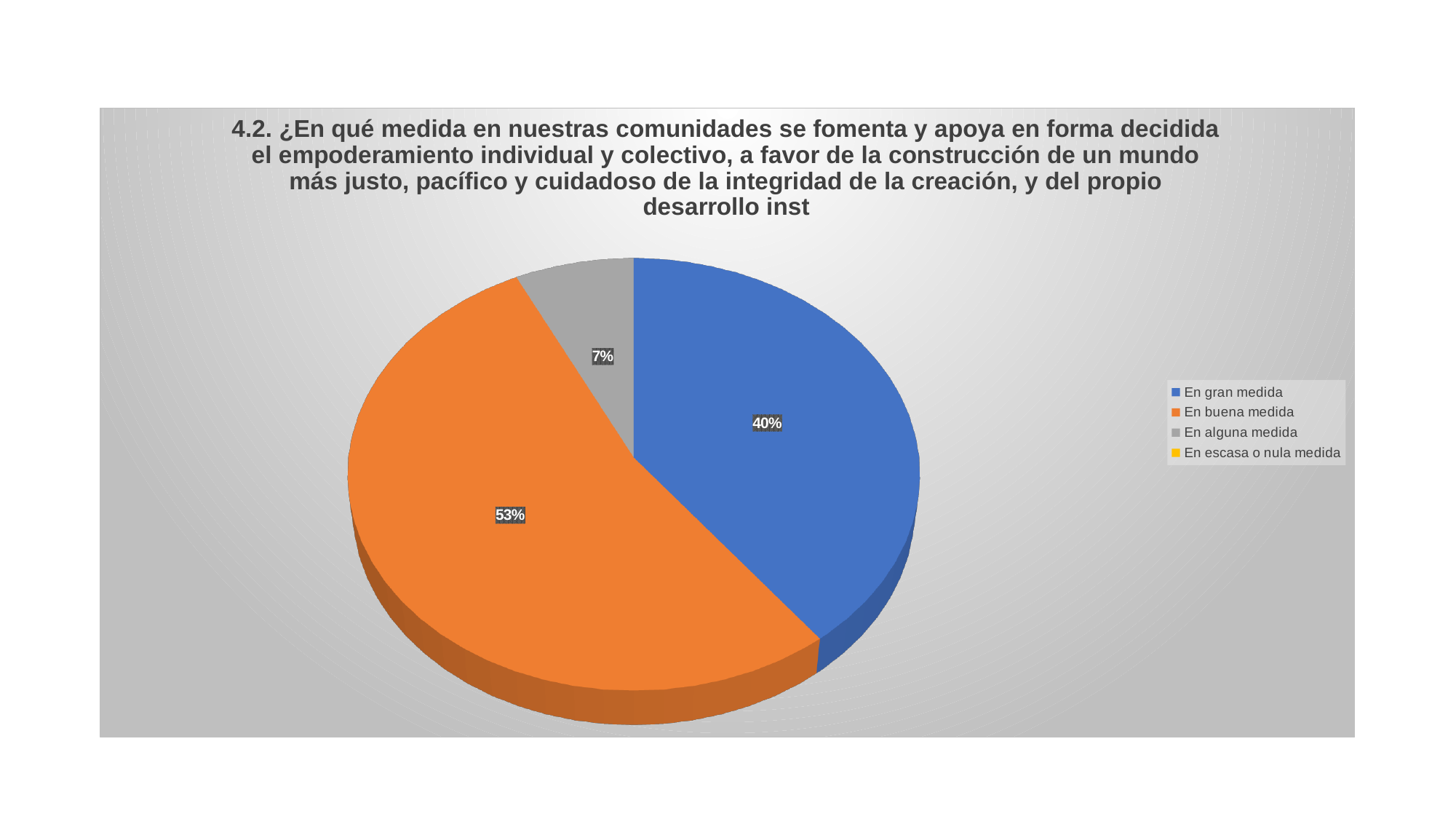
Which legend entry is shown in yellow? En escasa o nula medida What is the difference in percentage points between "En buena medida" and "En gran medida"? 13 What share of the pie does "En alguna medida" represent? 7% What colour is the slice for "En buena medida"? orange What is the difference in percentage points between "En gran medida" and "En alguna medida"? 33 Which category has the largest share of the pie? En buena medida What share of the pie does "En gran medida" represent? 40% What kind of chart is shown on the slide? pie chart Which category with a visible slice has the smallest share of the pie? En alguna medida What share of the pie does "En buena medida" represent? 53% How many entries does the legend list? 4 Which is larger, the share for "En gran medida" or the share for "En alguna medida"? En gran medida